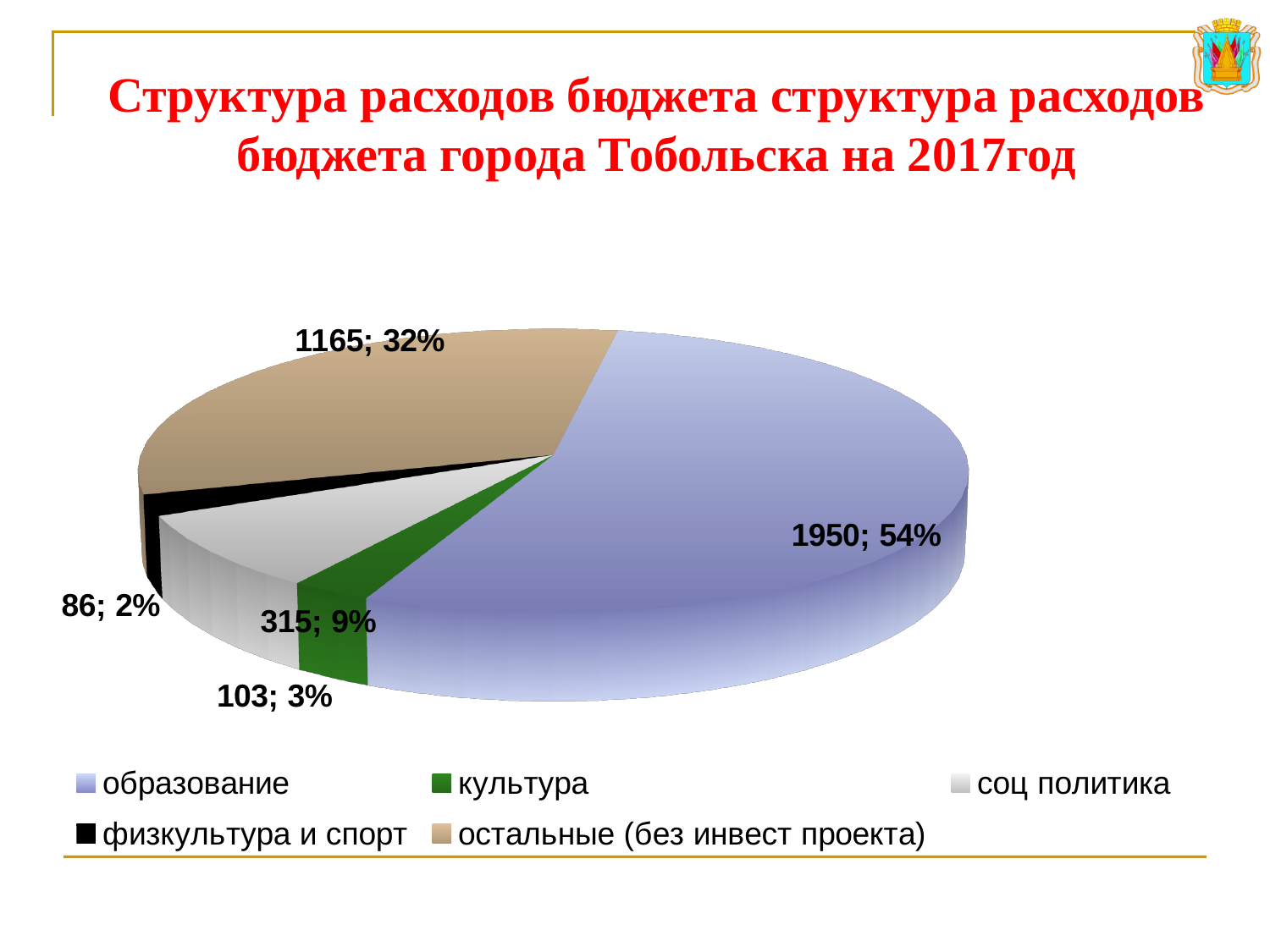
What kind of chart is shown on the slide? pie chart Which is larger, the value for соц политика or the value for культура? соц политика What value is shown for физкультура и спорт? 86; 2% Which colour represents остальные (без инвест проекта) in the pie chart? tan (beige) What value is shown for остальные (без инвест проекта)? 1165; 32% How many categories does the legend of the pie chart list? 5 Which category has the smallest slice of the pie? физкультура и спорт What value is shown for соц политика? 315; 9% Which category has the largest slice of the pie? образование What share of the pie does культура take? 3% What is the difference between the values for образование and остальные (без инвест проекта)? 785 What value is shown for образование? 1950; 54%